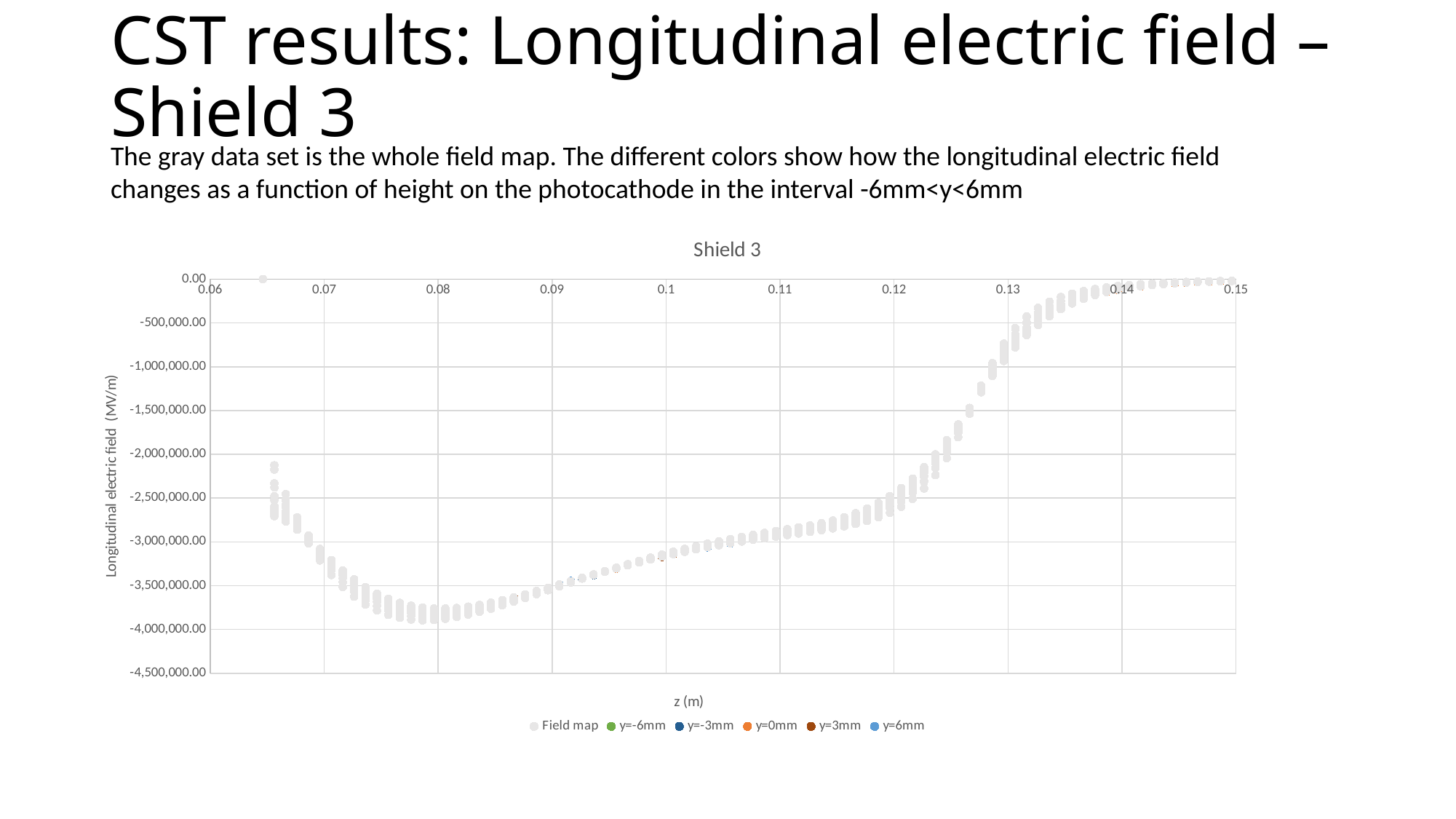
What kind of chart is shown on the slide? scatter chart Near which x-axis tick does the Field map reach its lowest value? 0.08 How many series does the chart legend list? 6 Is the Field map value at z = 0.12 greater or less than -3,000,000.00? greater Do the Field map values rise or fall as z increases from 0.065 to 0.08? fall Is the Field map value at z = 0.1 greater or less than -3,000,000.00? less Do the Field map values rise or fall as z increases from 0.08 to 0.15? rise Is the Field map value at z = 0.14 greater or less than -500,000.00? greater What is the title of the chart? Shield 3 Is the Field map value at z = 0.15 larger or smaller than the value at z = 0.09? larger What is the label of the x axis of the chart? z (m)